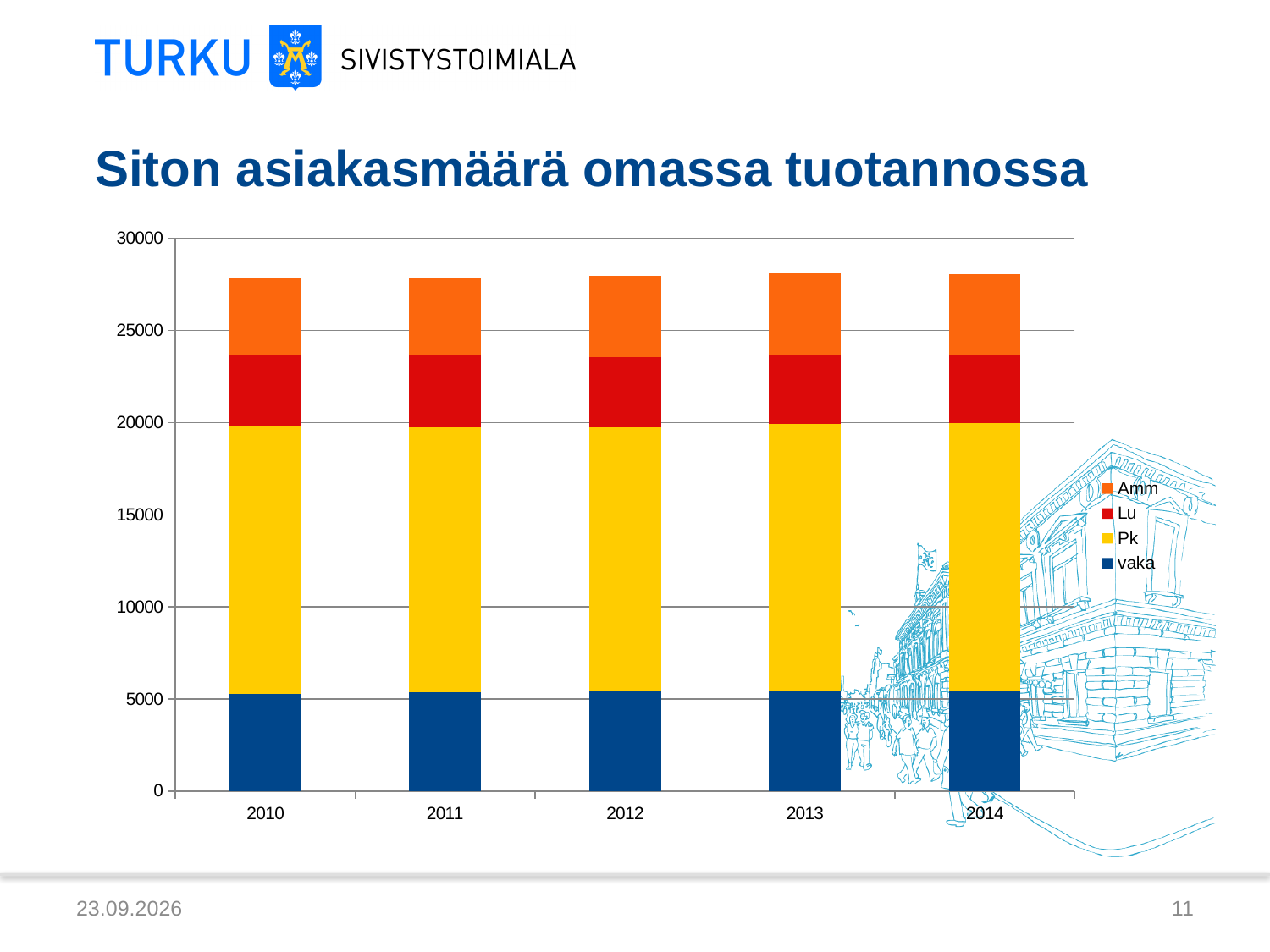
Which series forms the largest segment of the 2014 bar? Pk Which series is at the bottom of each stacked bar? vaka Which series is shown in yellow in the chart? Pk What kind of chart is shown on the slide? stacked bar chart Is the total of the stacked bar for 2014 greater or less than 30000? less How many years are shown on the x axis of the chart? 5 How many series does the chart's legend list? 4 Is the value for vaka in 2012 greater or less than 10000? less In 2011, which series has the larger segment, Lu or Pk? Pk What is the title of the chart on the slide? Siton asiakasmäärä omassa tuotannossa Is the total of the stacked bar for 2010 greater or less than 25000? greater In 2013, which series has the larger segment, Pk or vaka? Pk